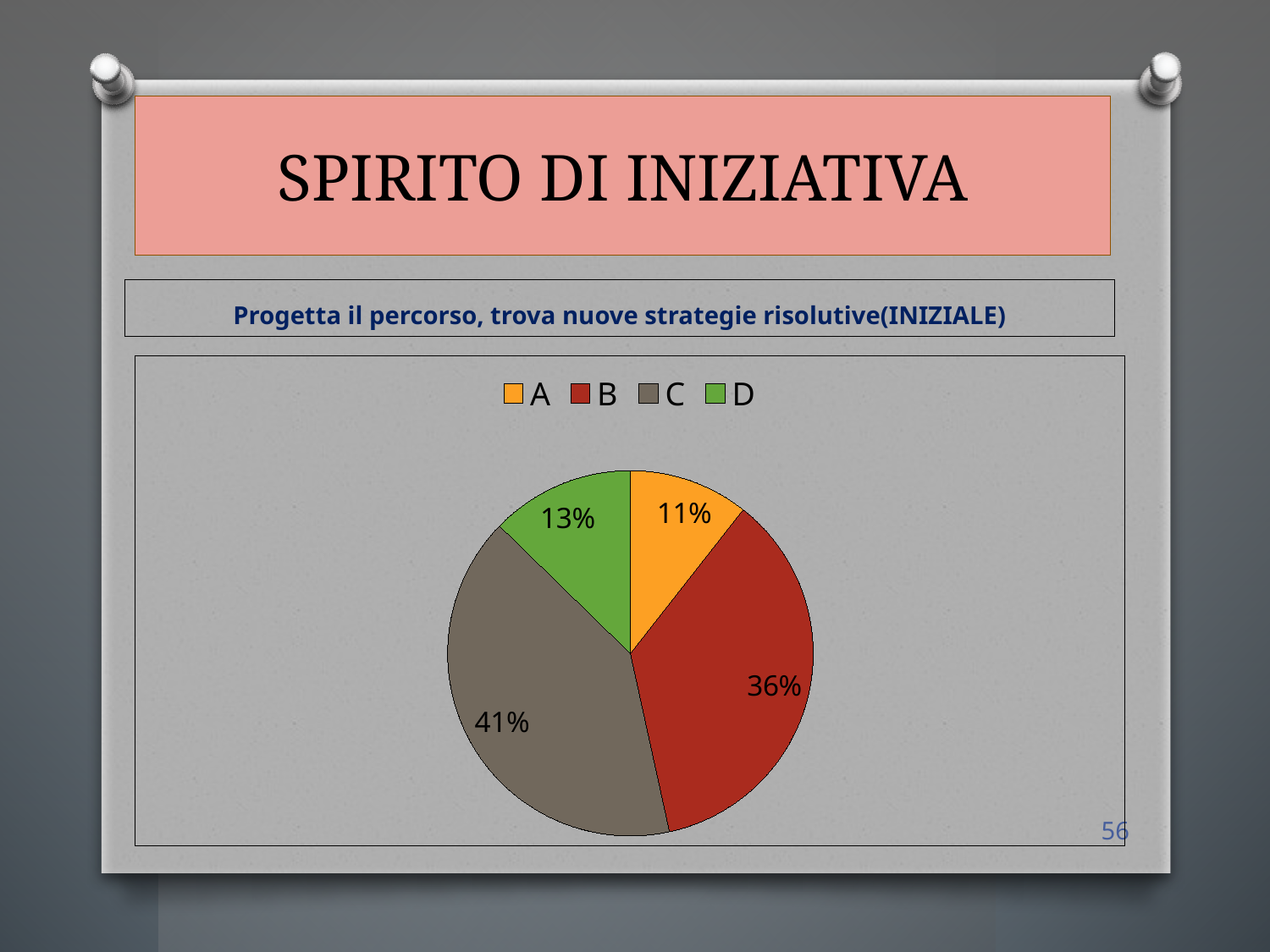
What percentage does slice A represent? 11% How many entries does the legend list? 4 What is the difference in percentage points between slice C and slice B? 5 Which category has the smallest share of the pie? A What percentage does slice D represent? 13% What kind of chart is shown on the slide? pie chart What percentage does slice C represent? 41% What percentage does slice B represent? 36% How many slices does the pie chart have? 4 What colour is the slice for category D? green Which is larger, the share for B or the share for D? B Which category has the largest share of the pie? C